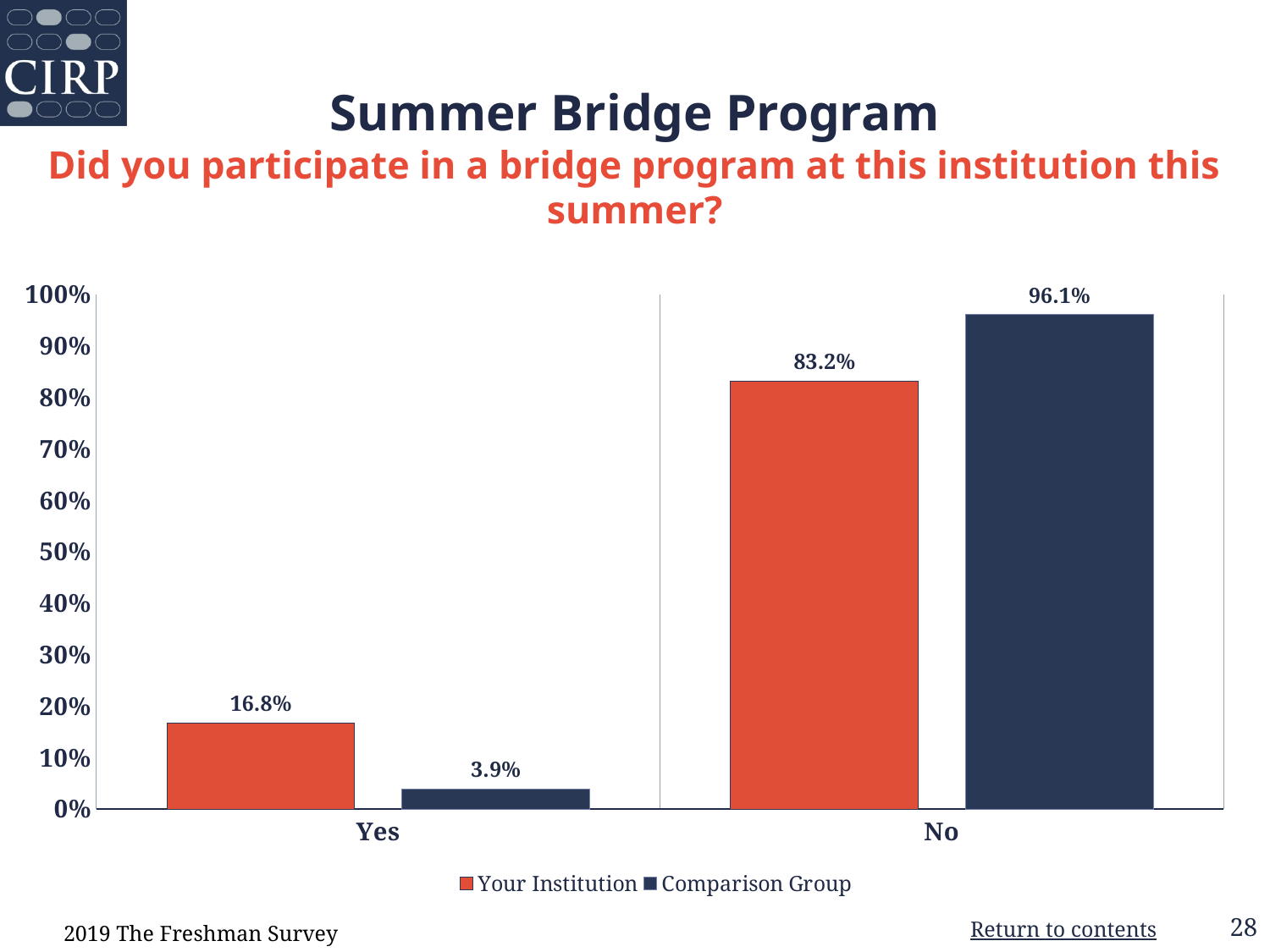
Which bar has the lowest value on the chart? Comparison Group, Yes What is the Comparison Group value for Yes? 3.9% For Yes, which is larger: Your Institution or the Comparison Group? Your Institution What kind of chart is shown on the slide? Bar chart How many response categories are shown on the x axis? 2 What percentage of Your Institution respondents answered Yes? 16.8% What is the difference between Your Institution and the Comparison Group for Yes? 12.9% How many series does the legend list? 2 Which bar has the highest value on the chart? Comparison Group, No What percentage of the Comparison Group answered No? 96.1% What is the difference between the Comparison Group and Your Institution for No? 12.9% What is the Your Institution value for No? 83.2%